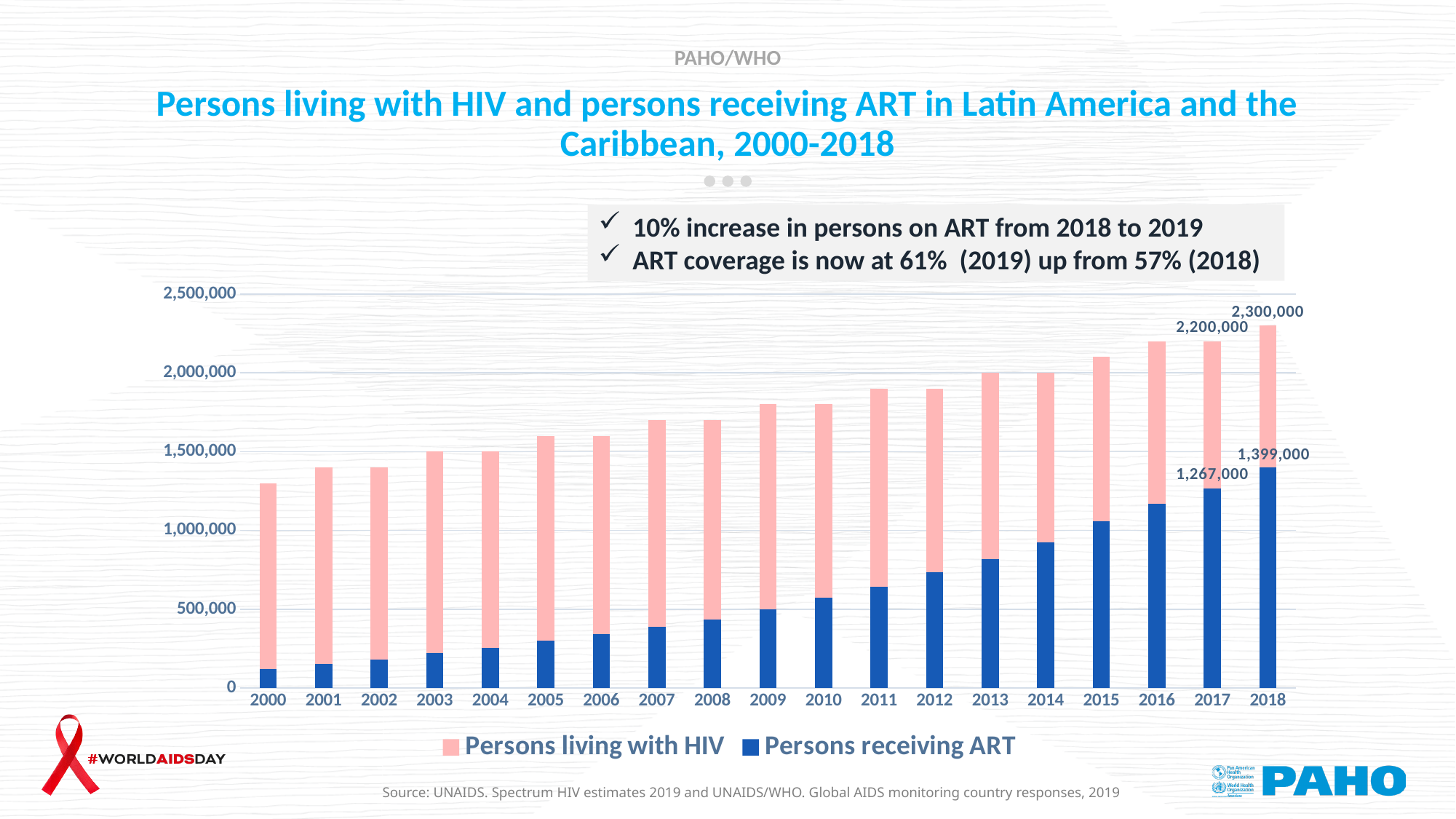
Which year has the highest number of persons receiving ART? 2018 By how much did the number of persons living with HIV increase from 2017 to 2018? 100,000 How many series does the legend list? 2 What is the number of persons receiving ART in 2018? 1,399,000 What kind of chart is shown on the slide? Bar chart What is the number of persons living with HIV in 2017? 2,200,000 Does the number of persons receiving ART rise or fall from 2000 to 2018? Rise By how much did the number of persons receiving ART increase from 2017 to 2018? 132,000 How many years are shown on the x axis of the chart? 19 What is the number of persons receiving ART in 2017? 1,267,000 What is the number of persons living with HIV in 2018? 2,300,000 Is the number of persons receiving ART in 2000 greater or less than 500,000? less